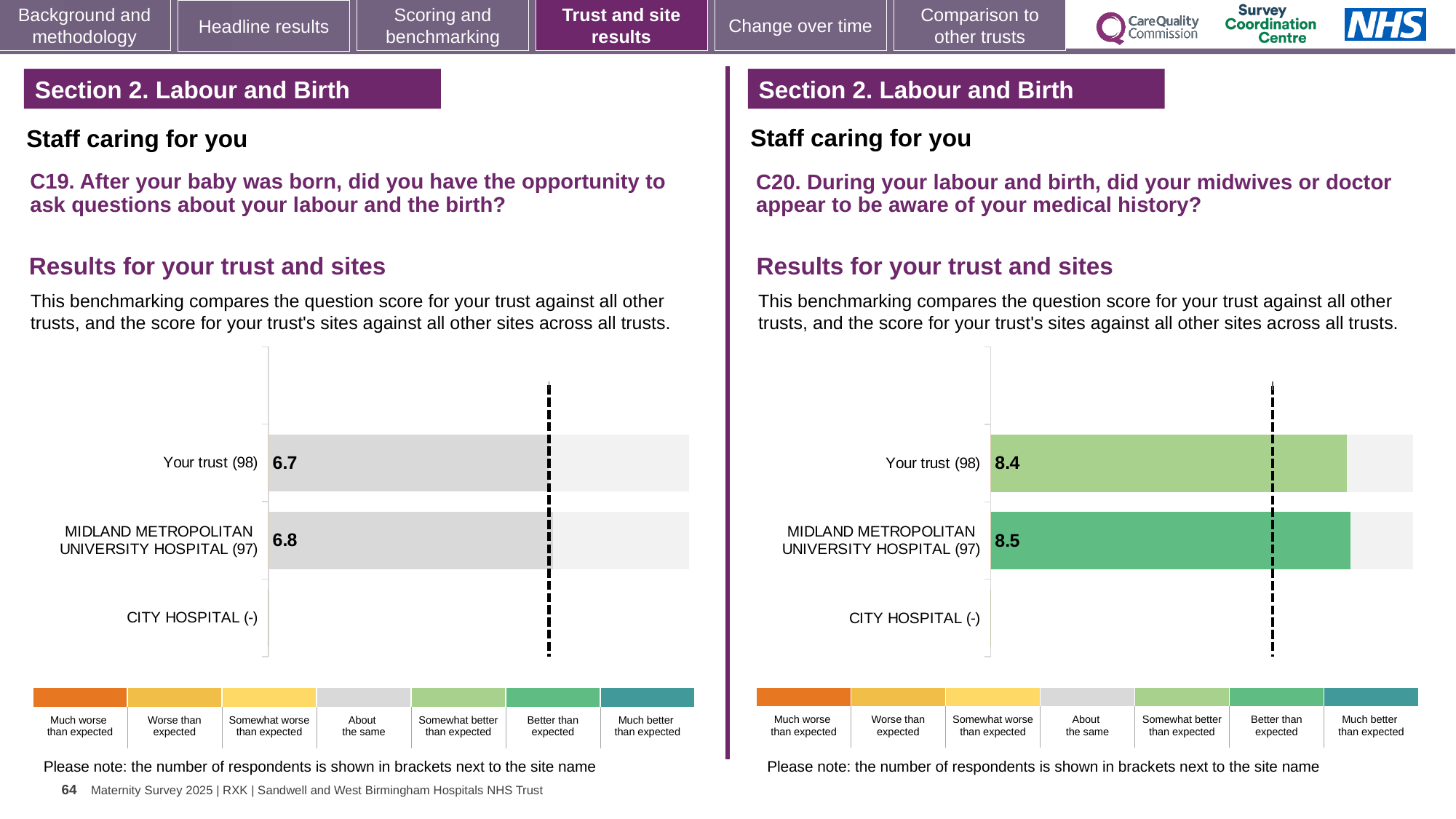
How many categories does the colour key below the left chart (C19) list? 7 On the right chart (C20), what is the score for Your trust? 8.4 On the left chart (C19), what is the score for Midland Metropolitan University Hospital? 6.8 On the right chart (C20), how many respondents are shown in brackets for Midland Metropolitan University Hospital? 97 On the right chart (C20), which has the higher score: Your trust or Midland Metropolitan University Hospital? Midland Metropolitan University Hospital On the right chart (C20), what is the score for Midland Metropolitan University Hospital? 8.5 What kind of chart is used on the right (C20)? Bar chart On the left chart (C19), how many respondents are shown in brackets for Your trust? 98 On the right chart (C20), what is the difference between the Midland Metropolitan University Hospital score and the Your trust score? 0.1 How many site/trust categories are listed on the left chart (C19)? 3 On the left chart (C19), what is the score for Your trust? 6.7 On the left chart (C19), which has the higher score: Your trust or Midland Metropolitan University Hospital? Midland Metropolitan University Hospital